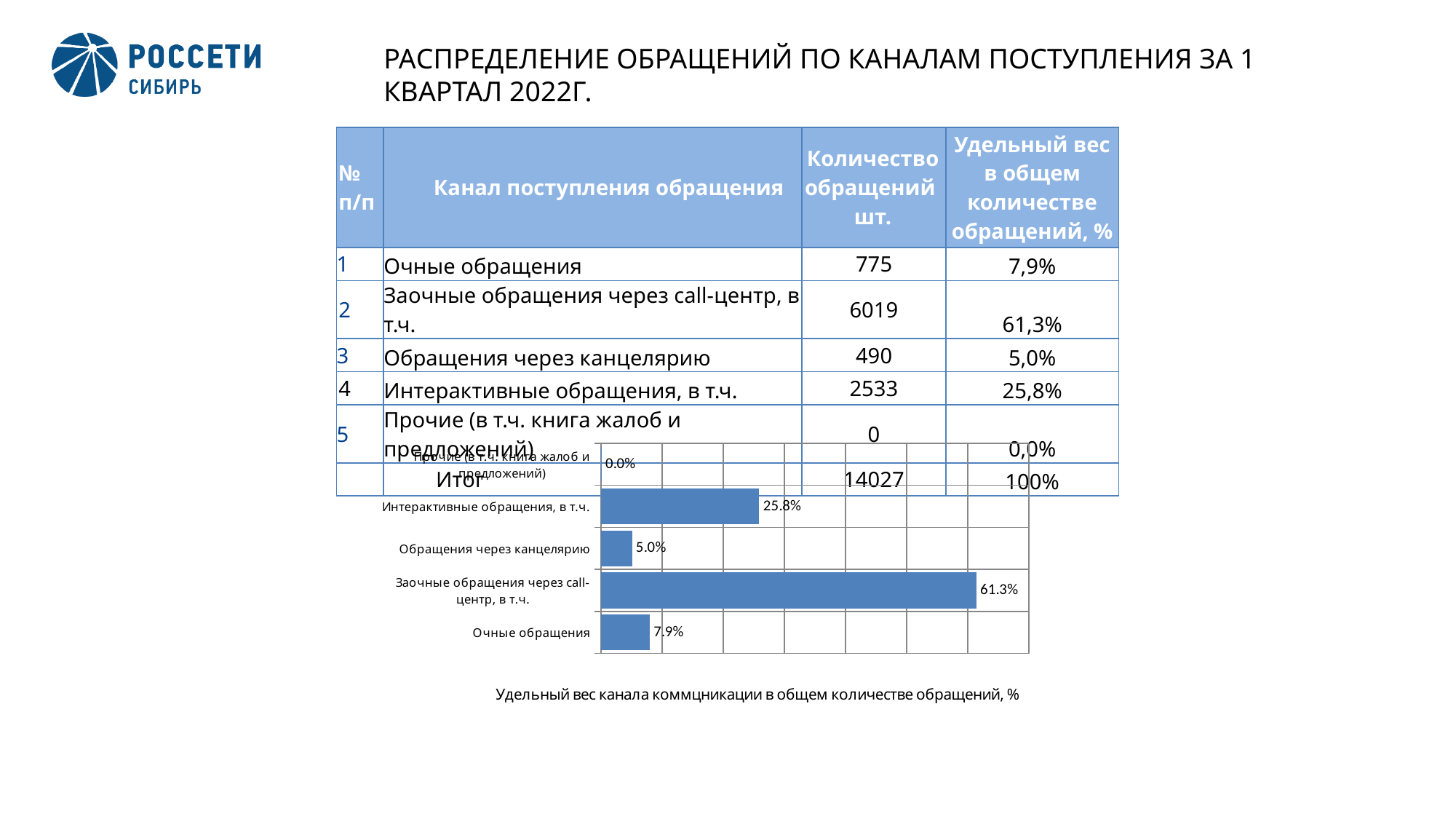
Which category has the lowest value in the bar chart? Прочие (в т.ч. книга жалоб и предложений) What is the value for Интерактивные обращения, в т.ч. in the bar chart? 25.8% What is the difference between the values for Заочные обращения через call-центр, в т.ч. and Интерактивные обращения, в т.ч. in the bar chart? 35.5% What is the value for Заочные обращения через call-центр, в т.ч. in the bar chart? 61.3% How many categories are shown in the bar chart? 5 Which is larger in the bar chart: Очные обращения or Обращения через канцелярию? Очные обращения What is the title shown below the bar chart? Удельный вес канала коммцникации в общем количестве обращений, % What is the value for Очные обращения in the bar chart? 7.9% What kind of chart is shown on the slide? Bar chart Which category has the highest value in the bar chart? Заочные обращения через call-центр, в т.ч. What is the difference between the values for Очные обращения and Обращения через канцелярию in the bar chart? 2.9% What is the value for Обращения через канцелярию in the bar chart? 5.0%